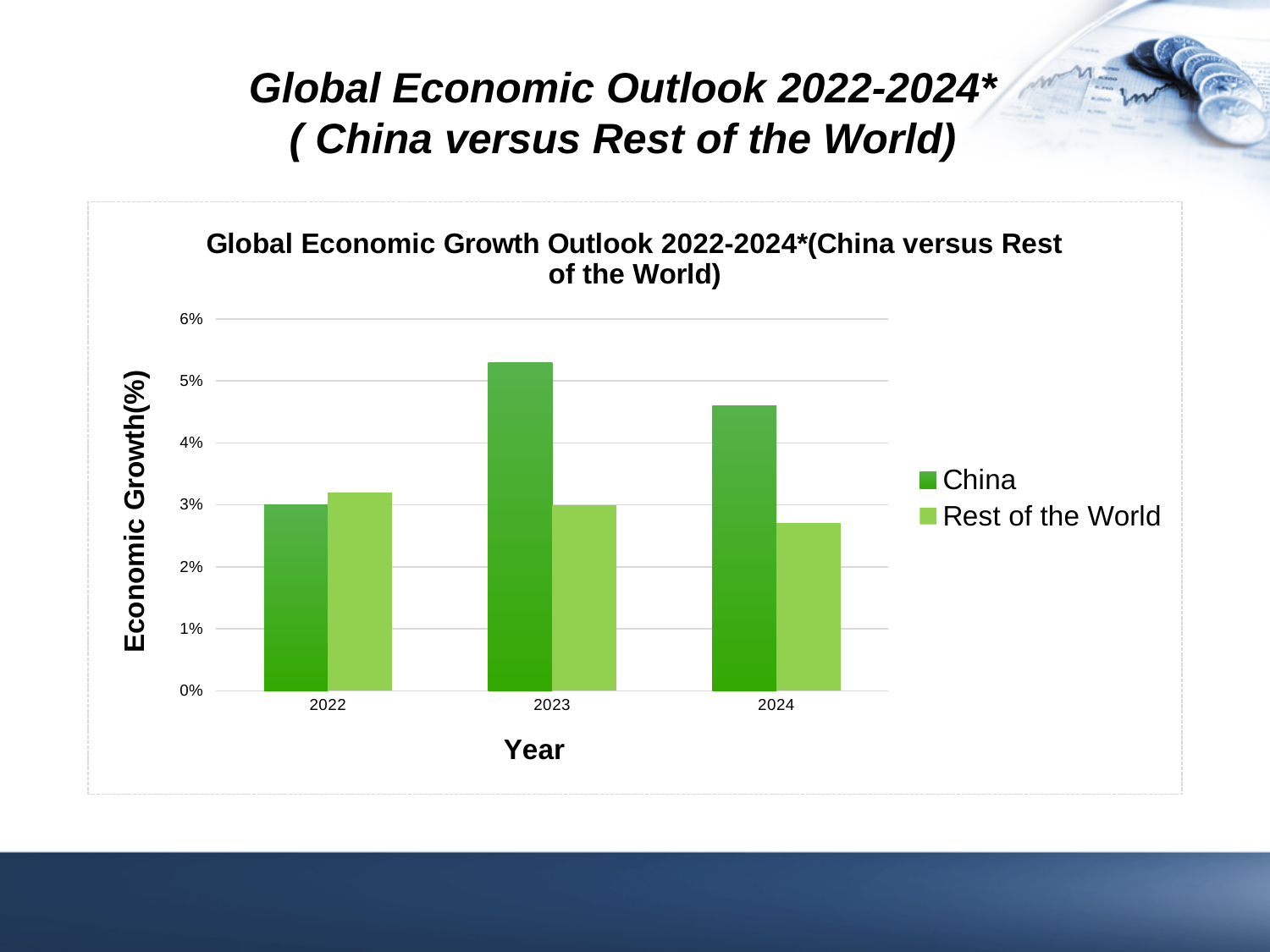
In which year is China's economic growth highest? 2023 What is the economic growth value for China in 2022? 3% Do the Rest of the World values rise or fall from 2022 to 2024? fall Is the value for China in 2023 greater or less than 5%? greater What kind of chart is shown on the slide? bar chart What is the title of the y axis? Economic Growth(%) In which year is the Rest of the World's economic growth lowest? 2024 How many series does the legend list? 2 Is the value for China in 2024 greater or less than 4%? greater Is the value for Rest of the World in 2024 greater or less than 3%? less In 2023, which is larger: China or Rest of the World? China How many years are shown on the x axis? 3